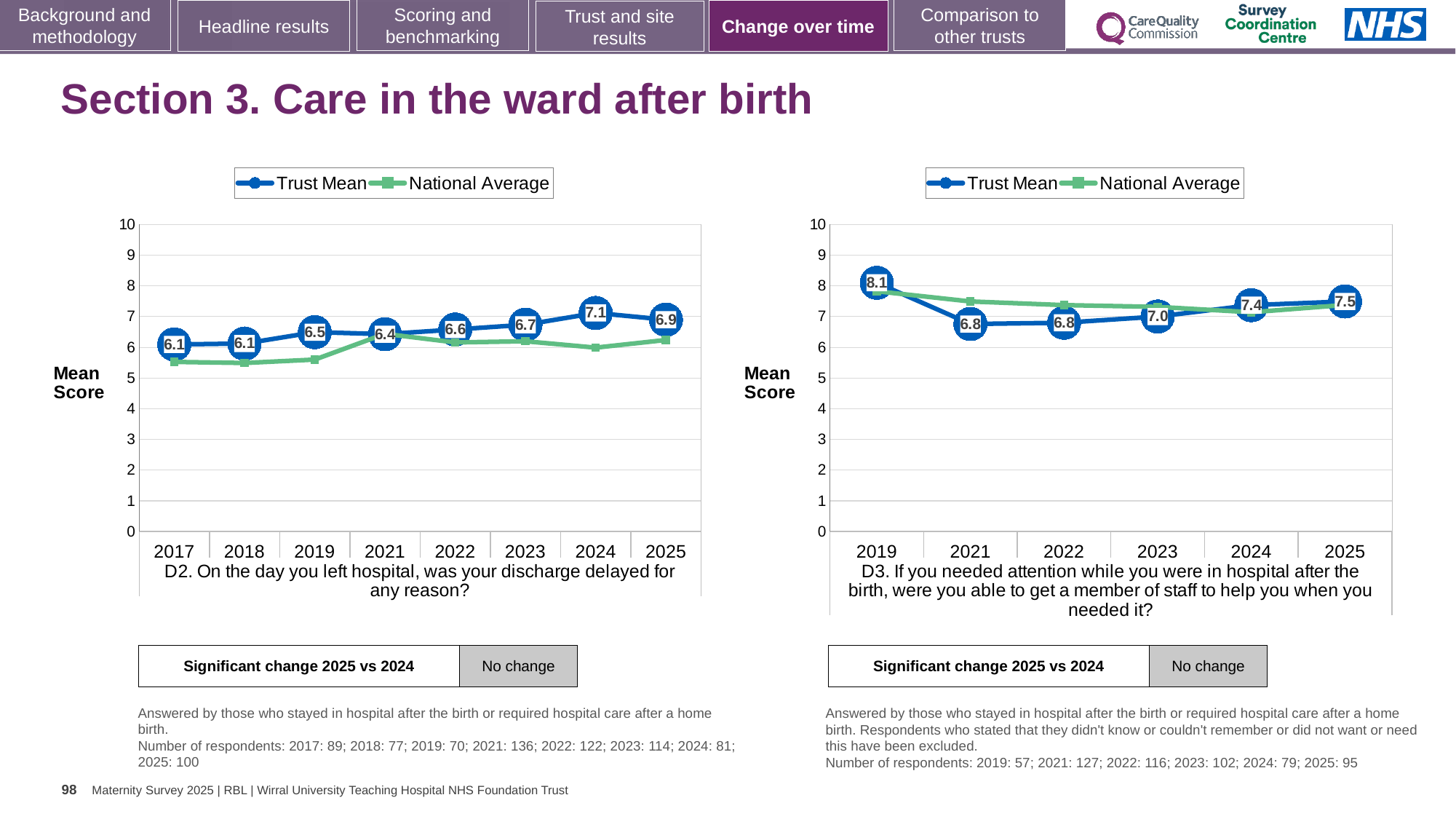
In the D2 chart (left), what is the Trust Mean score for 2024? 7.1 What type of chart is the D3 chart (right)? Line chart In the D2 chart (left), what is the difference between the Trust Mean scores for 2025 and 2017? 0.8 In the D3 chart (right), is the National Average for 2019 greater or less than 7? greater How many years are shown on the x axis of the D2 chart (left)? 8 In the D3 chart (right), what is the difference between the Trust Mean scores for 2019 and 2021? 1.3 In the D2 chart (left), is the Trust Mean score higher in 2023 or in 2025? 2025 In the D3 chart (right), which year has the highest Trust Mean score? 2019 In the D3 chart (right), what is the Trust Mean score for 2019? 8.1 How many series does the legend of the D3 chart (right) list? 2 In the D2 chart (left), is the National Average for 2018 greater or less than 6? less In the D2 chart (left), which year has the highest Trust Mean score? 2024